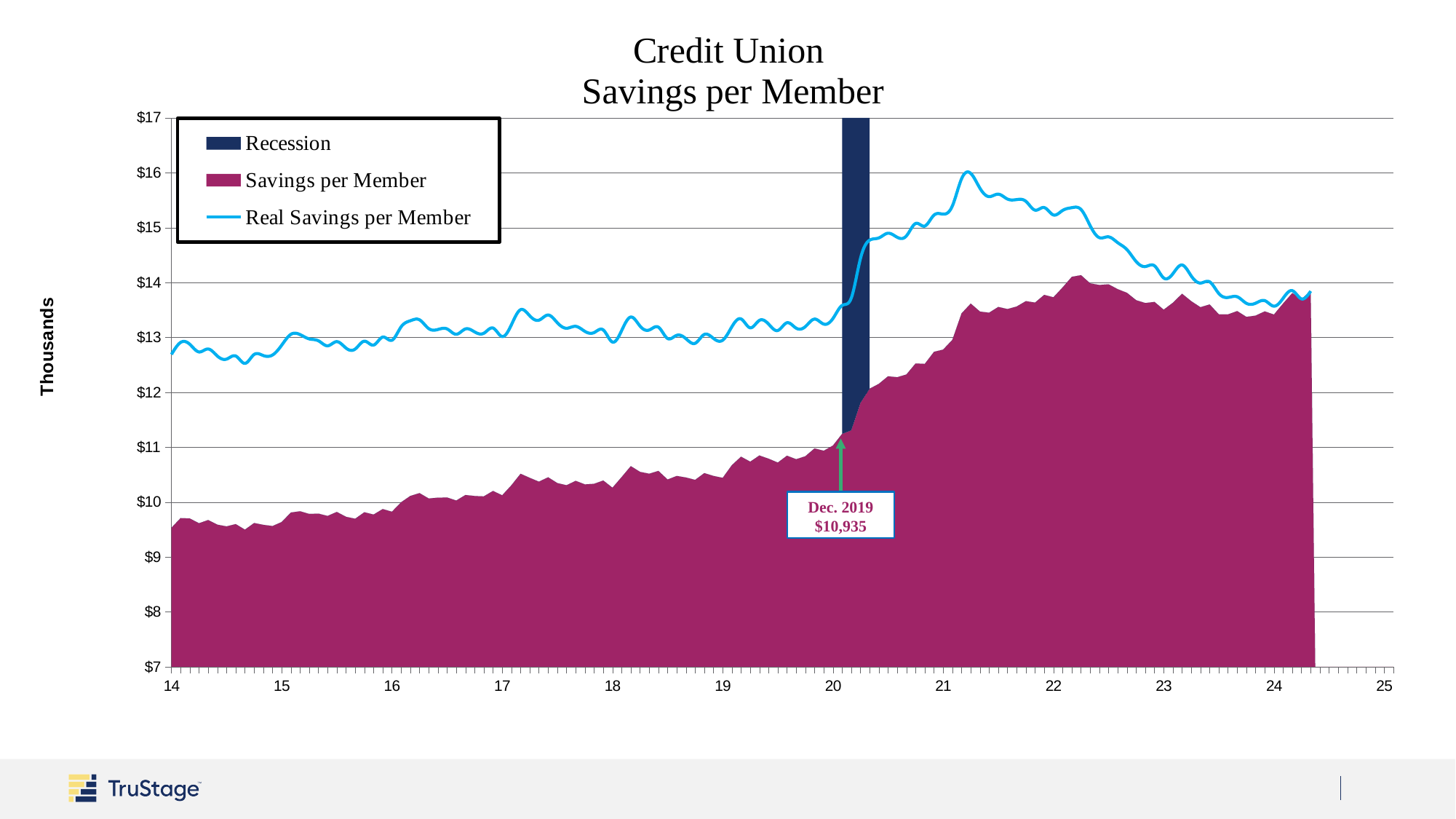
How many series does the legend list? 3 What is the Savings per Member value labelled for Dec. 2019? $10,935 Is the peak of the Real Savings per Member line greater or less than $15? greater Is the Savings per Member value at the start of 14 greater or less than $10? less Is the Savings per Member value at the start of 22 greater or less than $13? greater At the start of 14, which is higher: Real Savings per Member or Savings per Member? Real Savings per Member What kind of chart is used to plot the Savings per Member series? area chart In which year on the x axis does the Real Savings per Member line reach its highest point? 21 What is the title of the chart? Credit Union Savings per Member Does the Real Savings per Member line rise or fall from 21 to 24? fall Does the Savings per Member series rise or fall from 14 to 20? rise